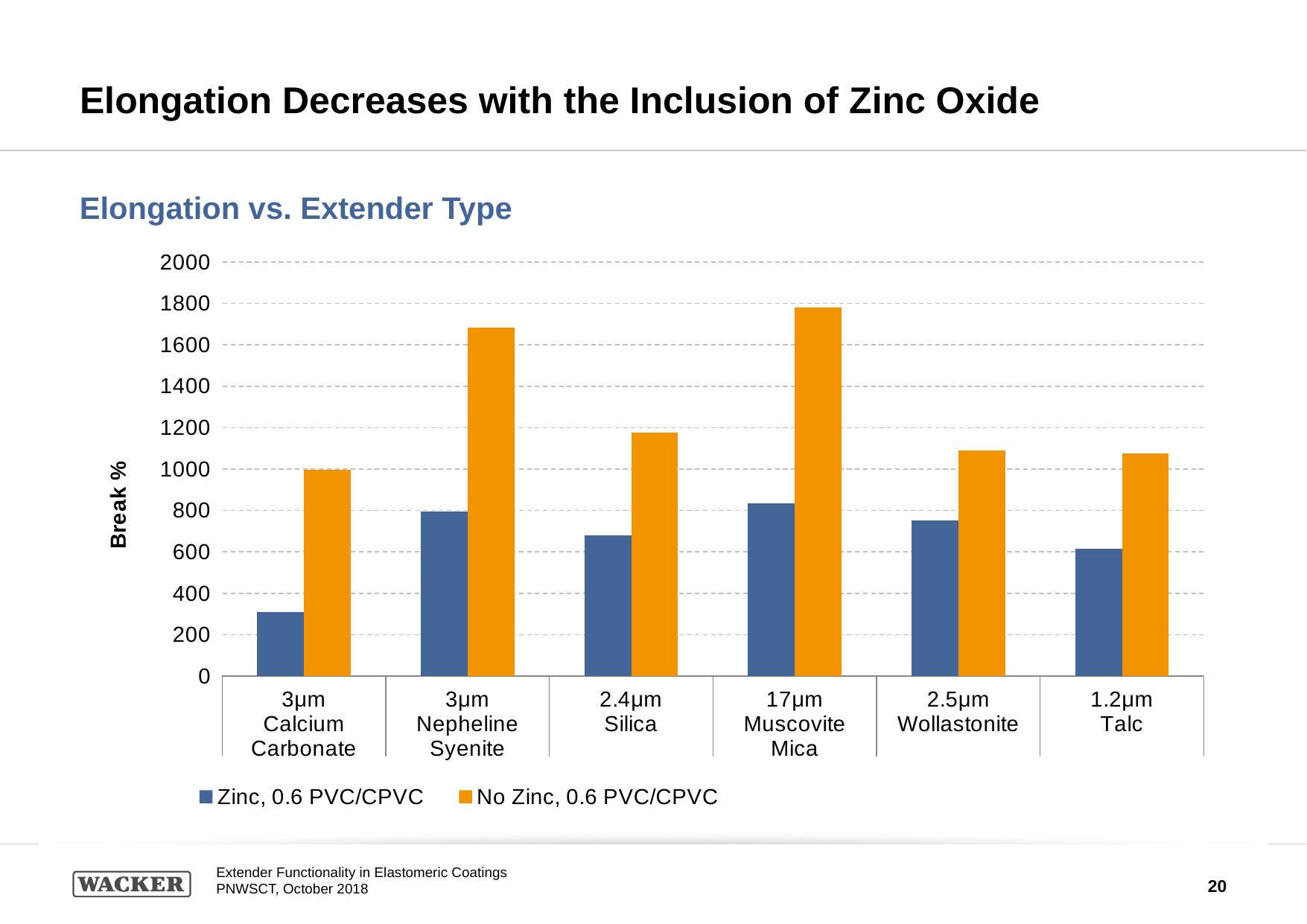
Is the No Zinc, 0.6 PVC/CPVC value for 2.4µm Silica greater or less than 1200? less Is the No Zinc, 0.6 PVC/CPVC value for 3µm Nepheline Syenite greater or less than 1600? greater What is the label on the vertical axis of the chart? Break % How many series does the chart's legend list? 2 Which extender type has the lowest Zinc, 0.6 PVC/CPVC value? 3µm Calcium Carbonate Is the Zinc, 0.6 PVC/CPVC value for 1.2µm Talc greater or less than 800? less Which extender type has the highest No Zinc, 0.6 PVC/CPVC value? 17µm Muscovite Mica Which is larger: the Zinc, 0.6 PVC/CPVC value for 2.4µm Silica or for 2.5µm Wollastonite? 2.5µm Wollastonite How many extender types are shown on the x axis of the chart? 6 What kind of chart is shown on the slide? bar chart Which is larger: the No Zinc, 0.6 PVC/CPVC value for 3µm Nepheline Syenite or for 2.4µm Silica? 3µm Nepheline Syenite